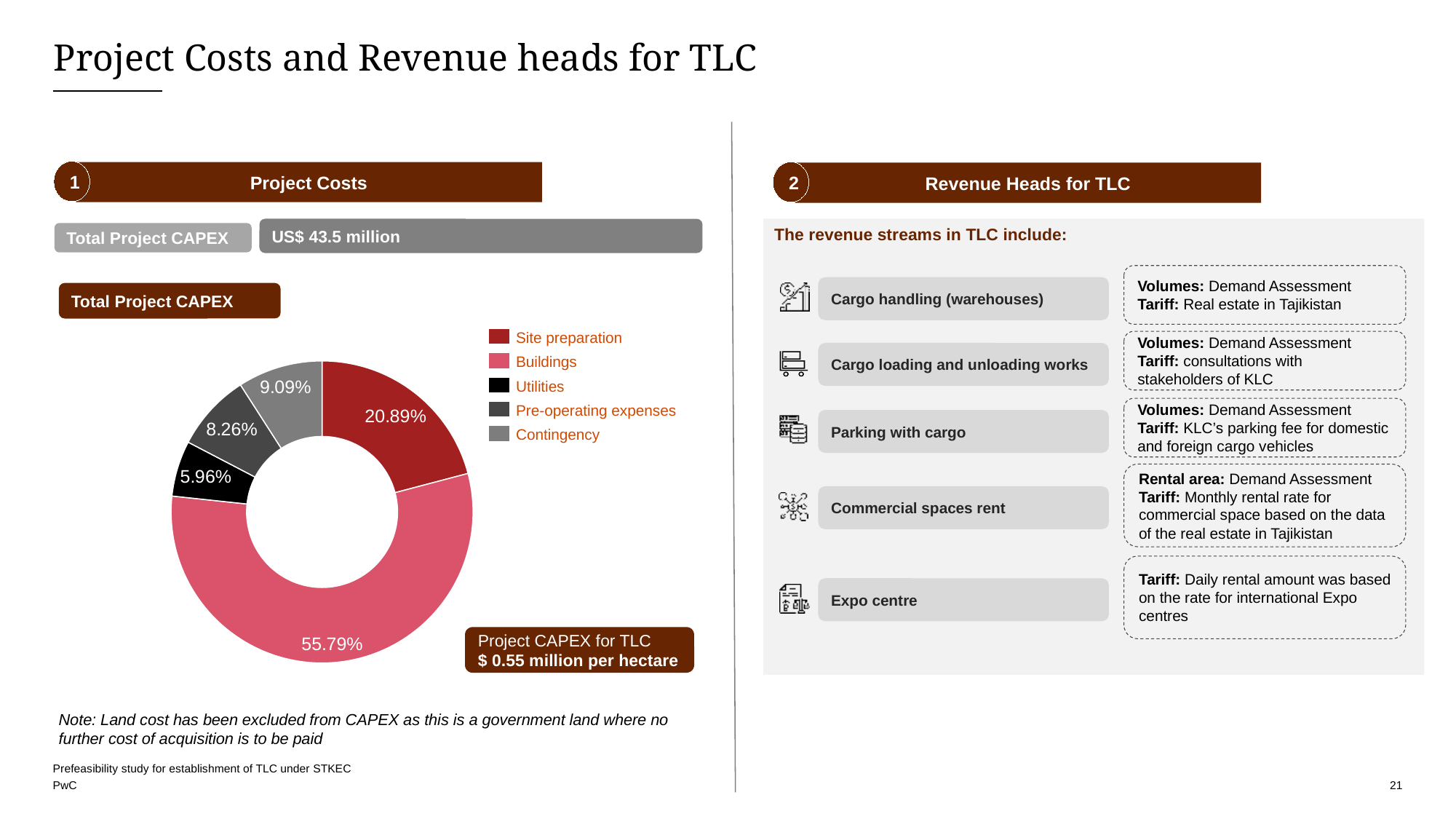
Which has a larger share of Total Project CAPEX, Contingency or Pre-operating expenses? Contingency What kind of chart is used to show Total Project CAPEX? Pie chart (donut) How many categories are shown in the Total Project CAPEX chart? 5 What share of Total Project CAPEX is Buildings? 55.79% Which category has the largest share of Total Project CAPEX? Buildings What share of Total Project CAPEX is Contingency? 9.09% Which category has the smallest share of Total Project CAPEX? Utilities What share of Total Project CAPEX is Pre-operating expenses? 8.26% What share of Total Project CAPEX is Utilities? 5.96% What colour represents Buildings in the Total Project CAPEX chart? Pink What share of Total Project CAPEX is Site preparation? 20.89% What is the difference in percentage points between the Buildings and Site preparation shares of Total Project CAPEX? 34.90